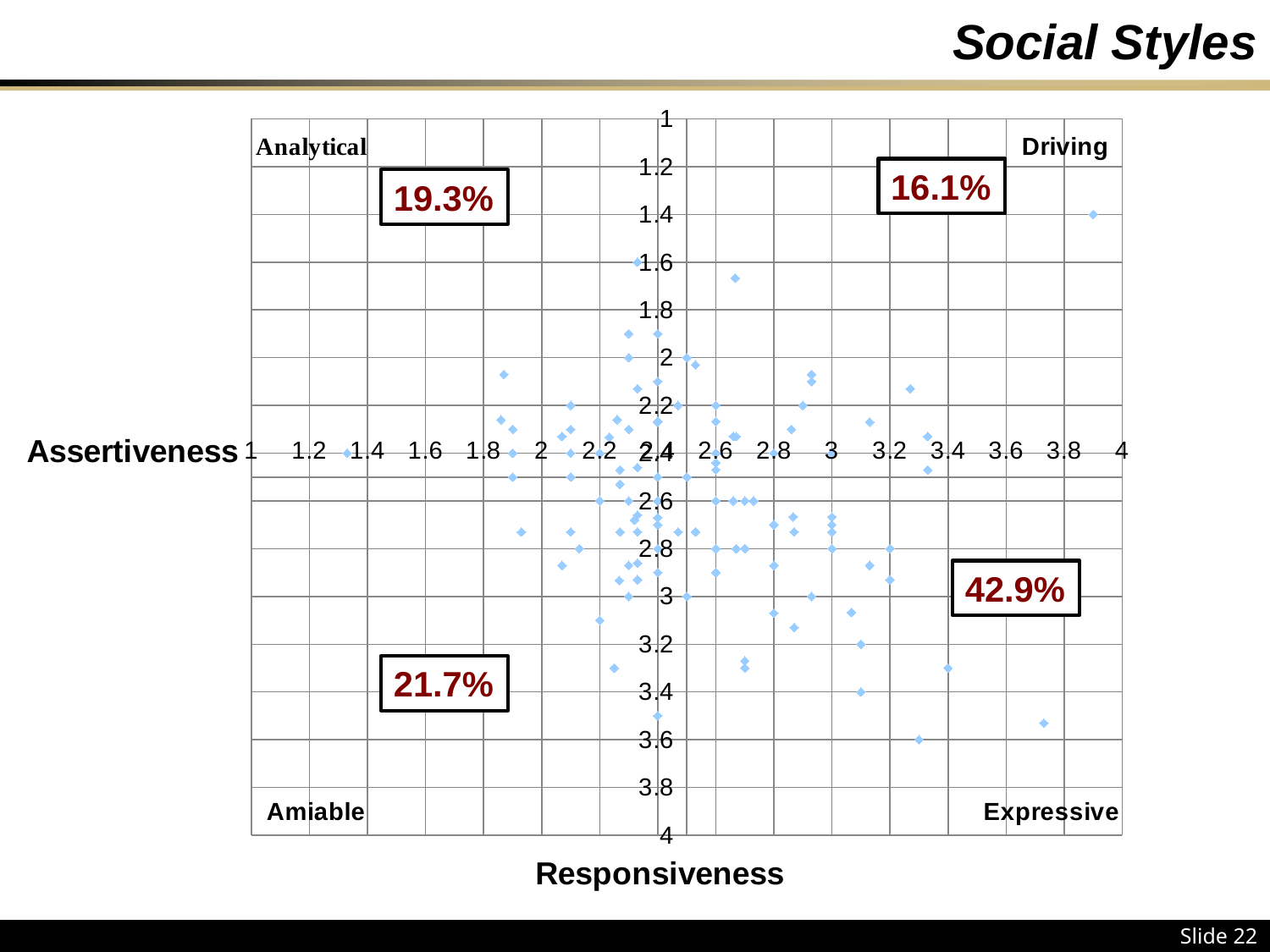
What kind of chart is shown on the slide? Scatter chart What is the label of the vertical axis? Assertiveness Which quadrant has the highest percentage? Expressive What is the difference between the Expressive and Analytical percentages? 23.6% What is the label of the horizontal axis? Responsiveness Which quadrant has a larger percentage, Amiable or Analytical? Amiable What percentage is shown in the Amiable quadrant? 21.7% What is the total of the four quadrant percentages? 100% What percentage is shown in the Driving quadrant? 16.1% Which quadrant has the lowest percentage? Driving What percentage is shown in the Analytical quadrant? 19.3% What percentage is shown in the Expressive quadrant? 42.9%